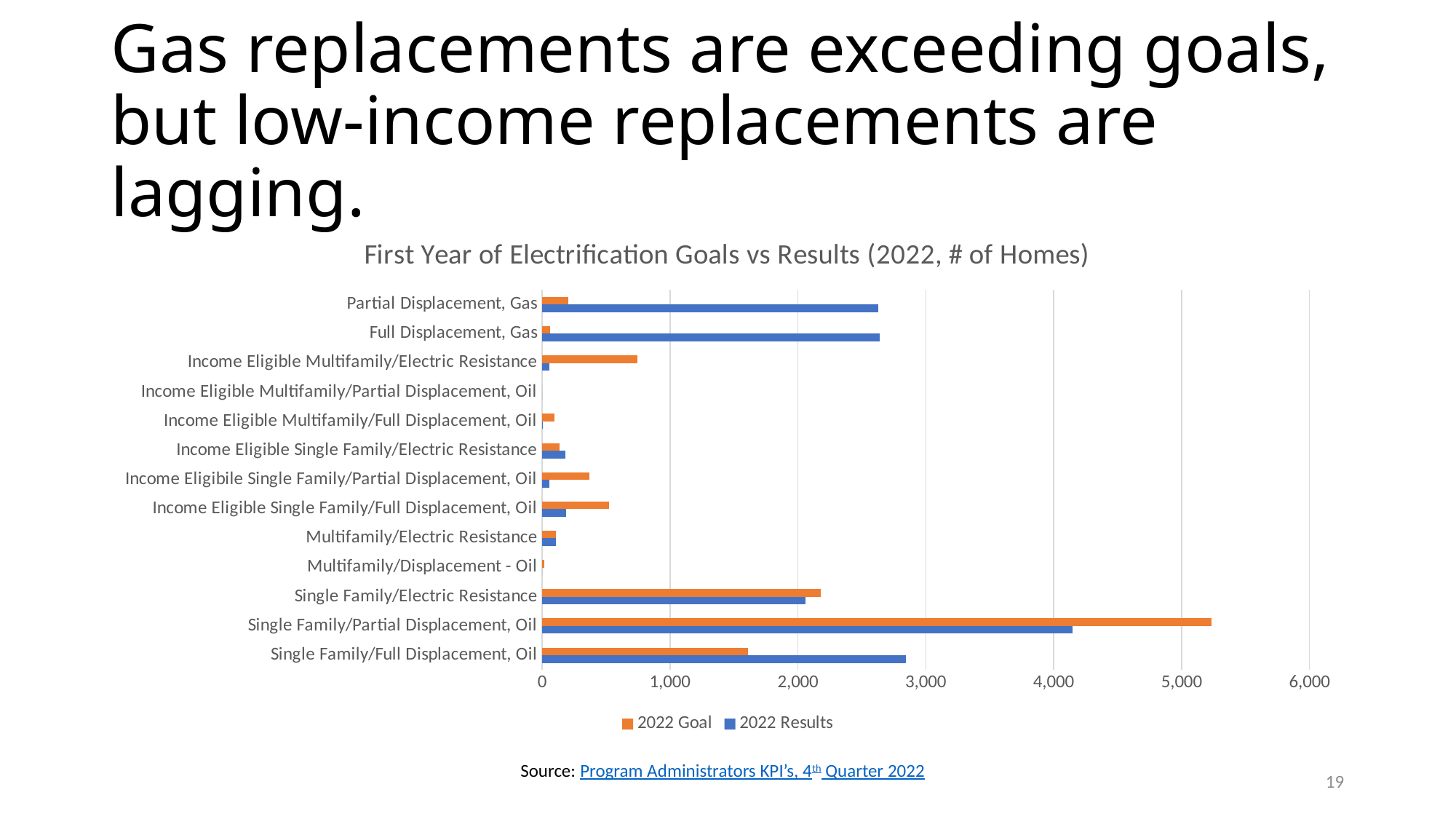
Is the 2022 Goal value for Income Eligible Multifamily/Electric Resistance greater or less than 1,000? less What is the title of the chart? First Year of Electrification Goals vs Results (2022, # of Homes) How many categories are shown on the chart? 13 Is the 2022 Goal value for Single Family/Partial Displacement, Oil greater or less than 5,000? greater Which category has the highest 2022 Goal value? Single Family/Partial Displacement, Oil How many series does the legend list? 2 What kind of chart is shown on the slide? Bar chart For Income Eligible Single Family/Full Displacement, Oil, which is larger: the 2022 Goal or the 2022 Results? 2022 Goal Which category has the highest 2022 Results value? Single Family/Partial Displacement, Oil For Partial Displacement, Gas, which is larger: the 2022 Goal or the 2022 Results? 2022 Results Is the 2022 Results value for Full Displacement, Gas greater or less than 2,000? greater